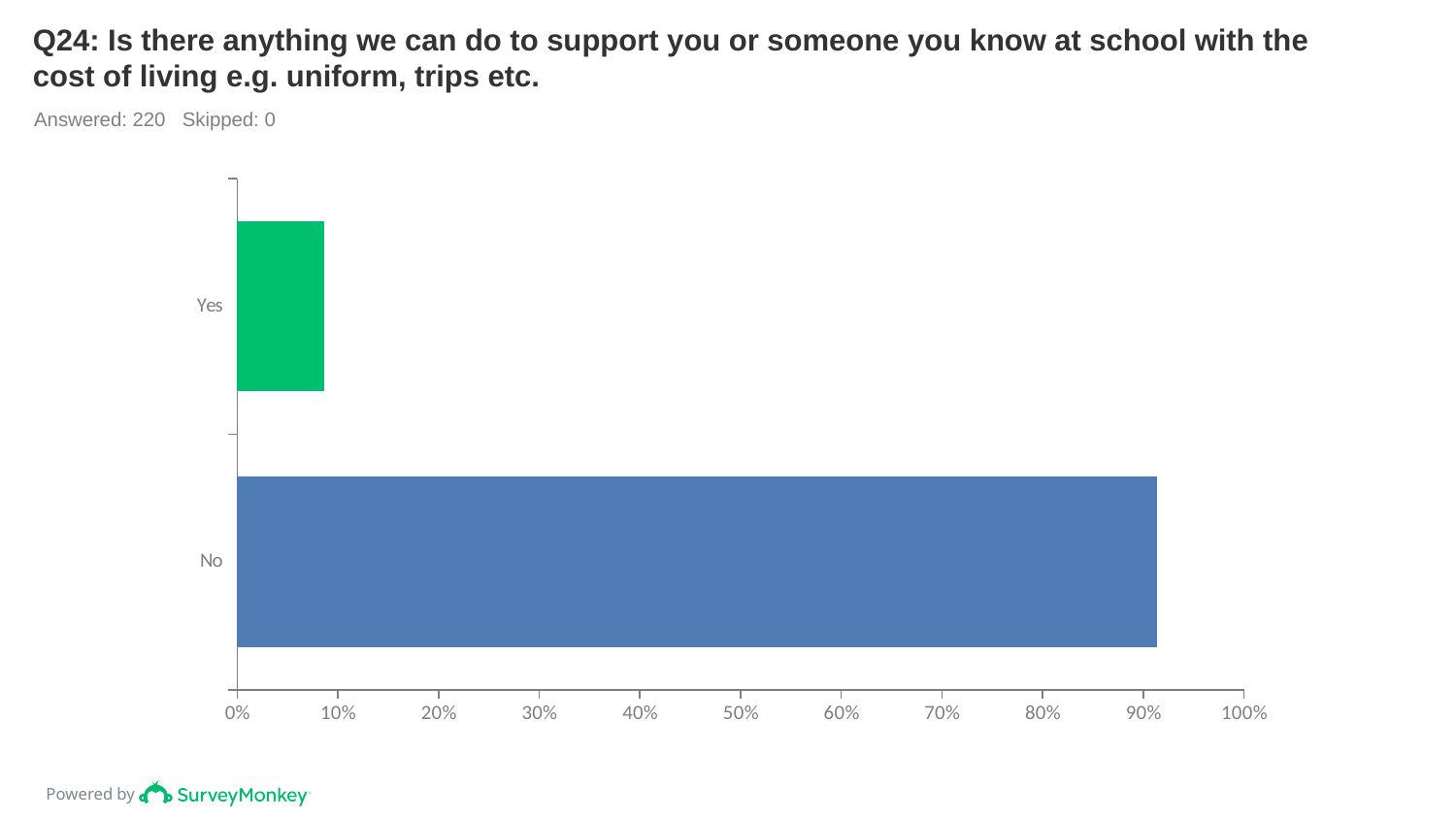
How many respondents answered this question according to the slide? 220 How many categories are plotted in the chart? 2 Which category has the lowest value? Yes Is the value for Yes greater or less than 20%? less Is the value for No greater or less than 90%? greater Is the value for Yes greater or less than 10%? less Which is larger, the value for Yes or the value for No? No Which category has the highest value? No What is the highest value shown on the x axis? 100% What kind of chart is shown on the slide? Bar chart